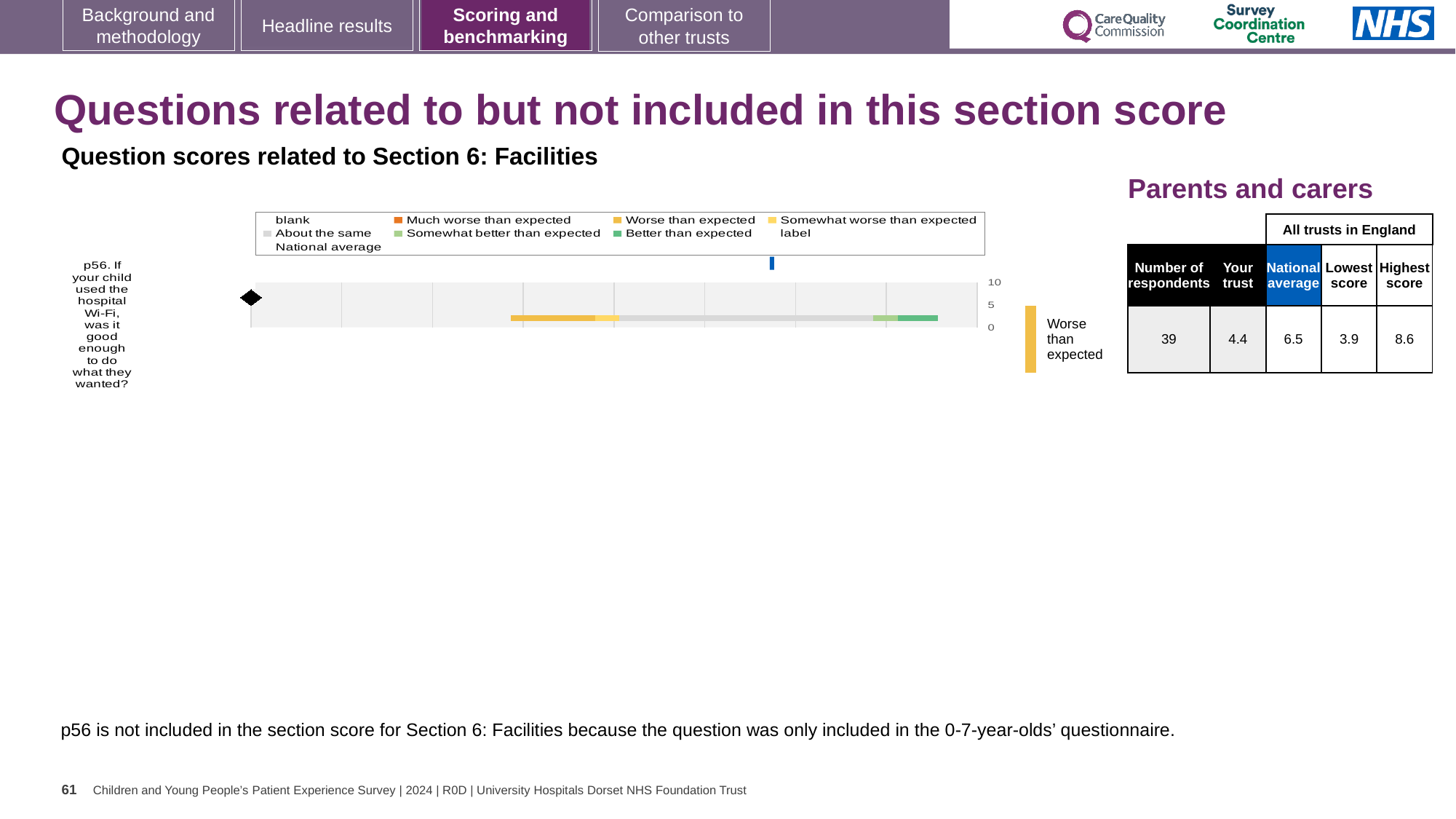
In the table beside the chart, how many respondents answered p56? 39 In the table beside the chart, what is the National average score for p56? 6.5 What kind of chart is shown on the slide? bar chart Which question number is plotted in the chart? p56 Which is larger for p56: the 'Your trust' score or the National average? National average In the table beside the chart, what is the Highest score across all trusts in England for p56? 8.6 How many questions (categories) are plotted in the chart? 1 What is the difference between the National average (6.5) and the 'Your trust' score (4.4) for p56? 2.1 What is the highest value shown on the chart's axis? 10 In the table beside the chart, what is the Lowest score across all trusts in England for p56? 3.9 In the table beside the chart, what is the 'Your trust' score for p56? 4.4 What rating label is shown next to the chart for p56? Worse than expected